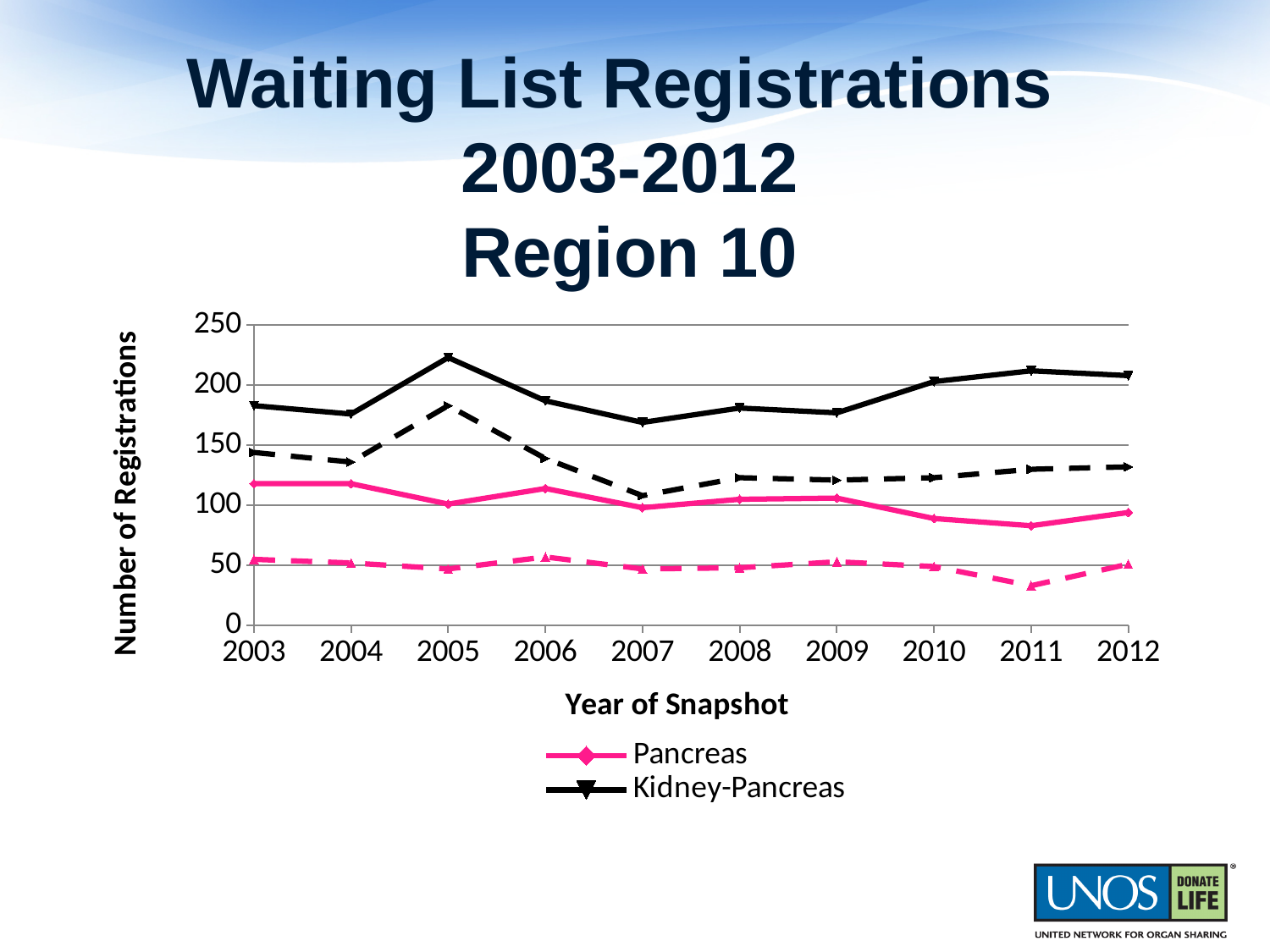
Is the Kidney-Pancreas value for 2007 greater or less than 200? less In 2005, which is larger: the Pancreas value or the Kidney-Pancreas value? Kidney-Pancreas Is the Kidney-Pancreas value for 2005 greater or less than 200? greater How many years are shown on the x axis? 10 Does the Kidney-Pancreas line rise or fall from 2009 to 2011? rise In which year is the Kidney-Pancreas value highest? 2005 In which year is the Pancreas value lowest? 2011 What kind of chart is shown on the slide? line chart How many series does the legend list? 2 In which year is the Kidney-Pancreas value lowest? 2007 Is the Pancreas value for 2011 greater or less than 100? less